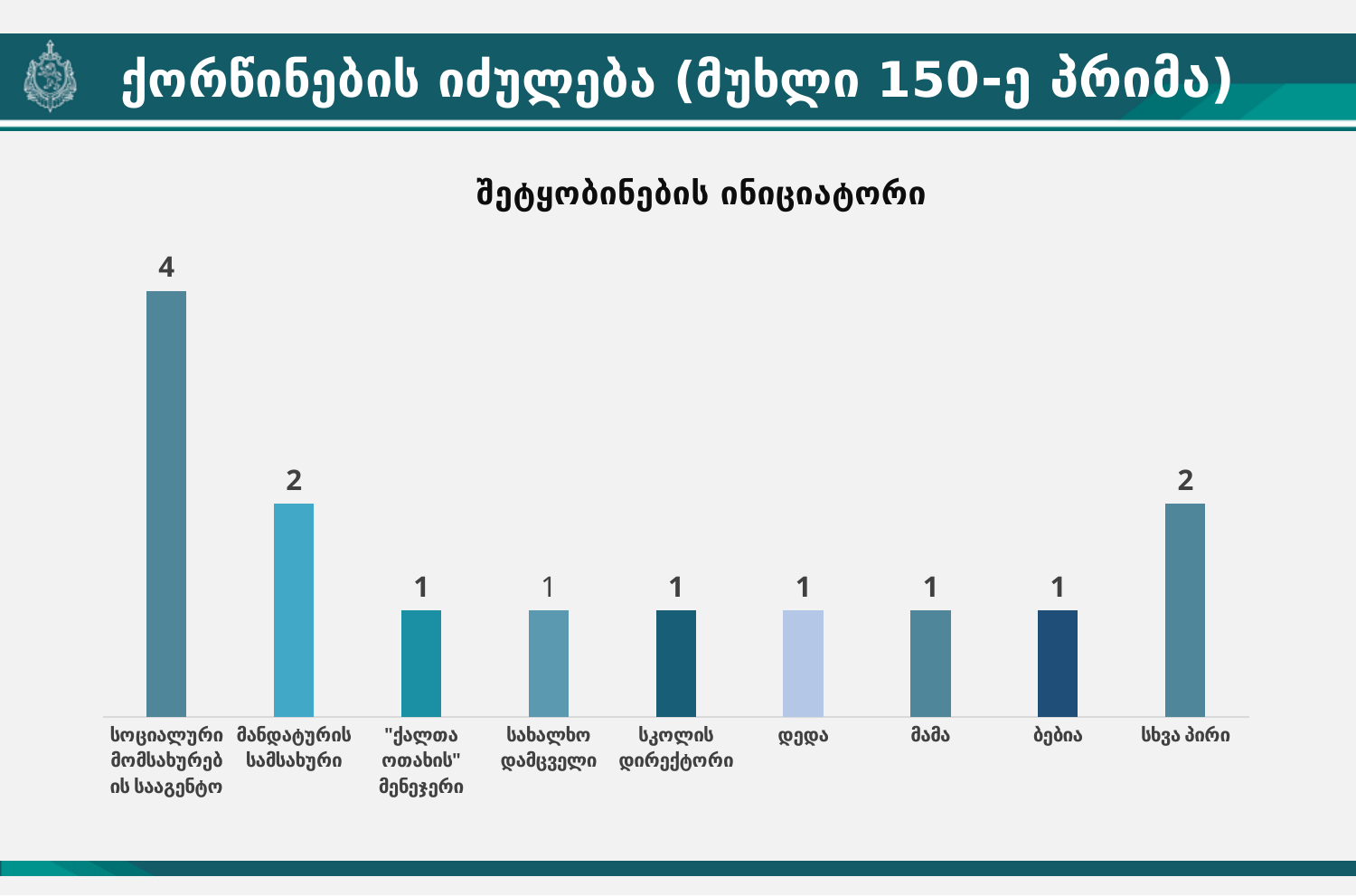
Which is larger, the value for სხვა პირი or the value for ბებია? სხვა პირი What is the value for სხვა პირი? 2 What is the difference between the values for სხვა პირი and მამა? 1 What is the difference between the values for სოციალური მომსახურების სააგენტო and მანდატურის სამსახური? 2 What is the title of the chart? შეტყობინების ინიციატორი What is the value for სოციალური მომსახურების სააგენტო? 4 What type of chart is shown on the slide? bar chart What is the value for სკოლის დირექტორი? 1 How many categories are shown on the x axis of the chart? 9 Which category has the highest value? სოციალური მომსახურების სააგენტო What is the value for დედა? 1 What is the value for მანდატურის სამსახური? 2